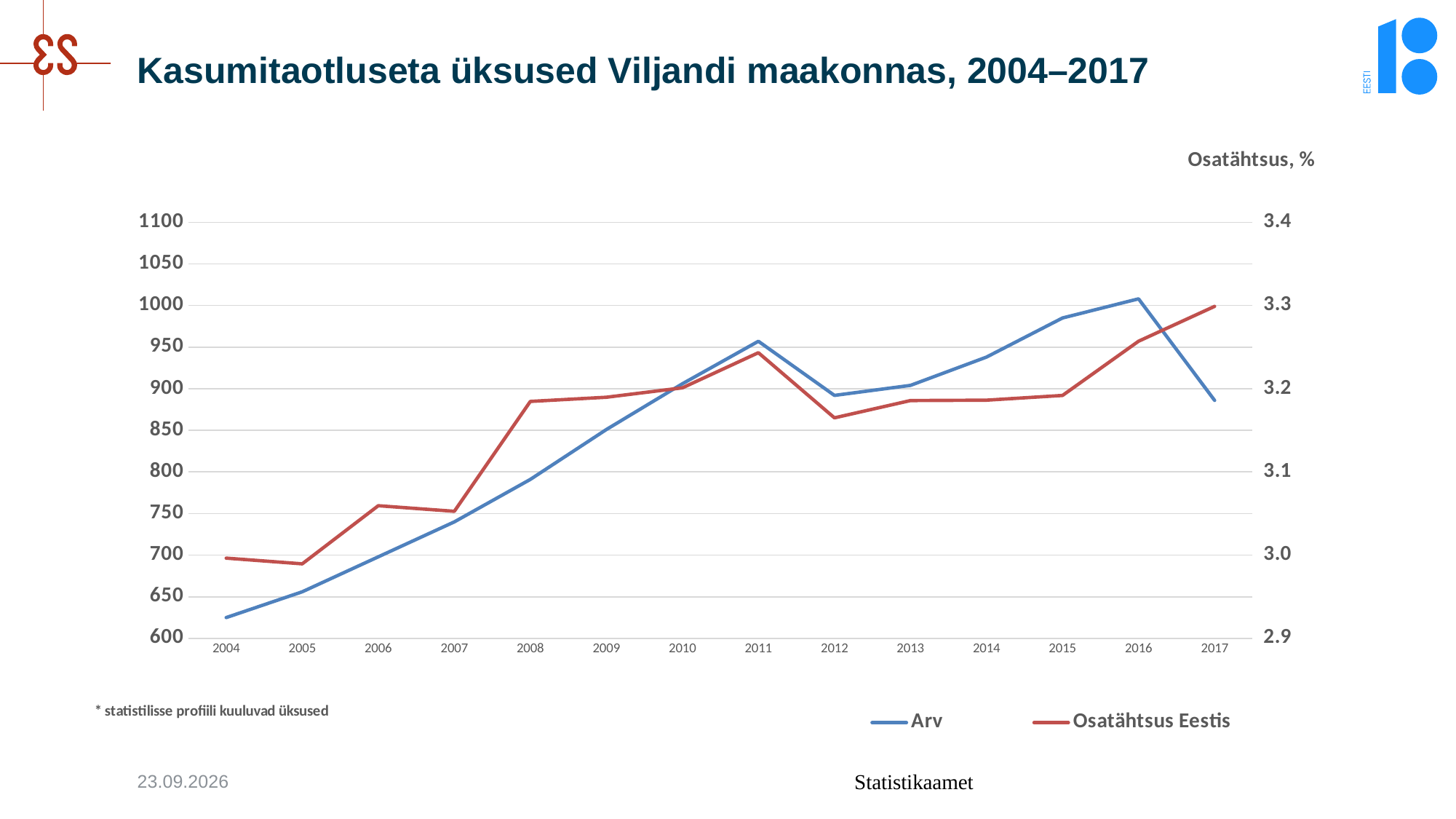
Is the Arv value for 2016 greater or less than 1000? greater Which year has the highest value for the Arv series? 2016 Which year has the highest value for the Osatähtsus Eestis series? 2017 How many series does the legend list? 2 What is the title of the chart? Osatähtsus, % What kind of chart is shown on the slide? line chart Does the Arv series rise or fall from 2004 to 2011? rise Which year has the lowest value for the Arv series? 2004 Which year has the larger Arv value, 2016 or 2017? 2016 How many years are plotted along the x axis? 14 Is the Arv value for 2004 greater or less than 650? less Is the Osatähtsus Eestis value for 2012 greater or less than 3.2? less